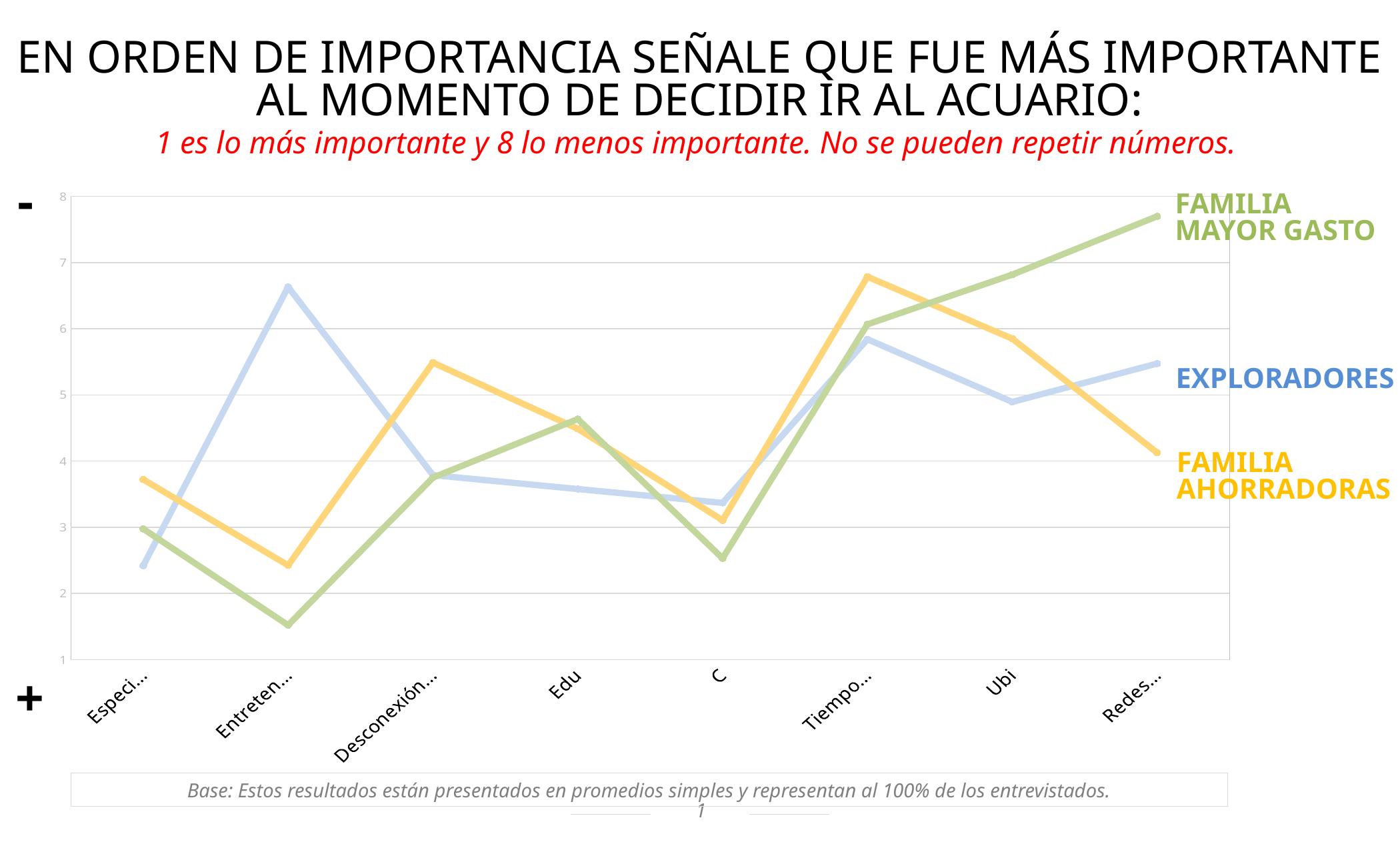
For the FAMILIA MAYOR GASTO series, which category has the highest value? Redes... What colour is the line for the EXPLORADORES series? blue At Entreten..., which series has the higher value, EXPLORADORES or FAMILIA AHORRADORAS? EXPLORADORES At Redes..., which series has the higher value, FAMILIA MAYOR GASTO or FAMILIA AHORRADORAS? FAMILIA MAYOR GASTO Is the value for FAMILIA AHORRADORAS at Desconexión... greater or less than 5? greater Is the value for FAMILIA MAYOR GASTO at Entreten... greater or less than 2? less How many series are plotted on the chart? 3 For the FAMILIA MAYOR GASTO series, which category has the lowest value? Entreten... Is the value for FAMILIA MAYOR GASTO at Redes... greater or less than 7? greater How many categories are shown along the x axis of the chart? 8 What kind of chart is shown on the slide? line chart